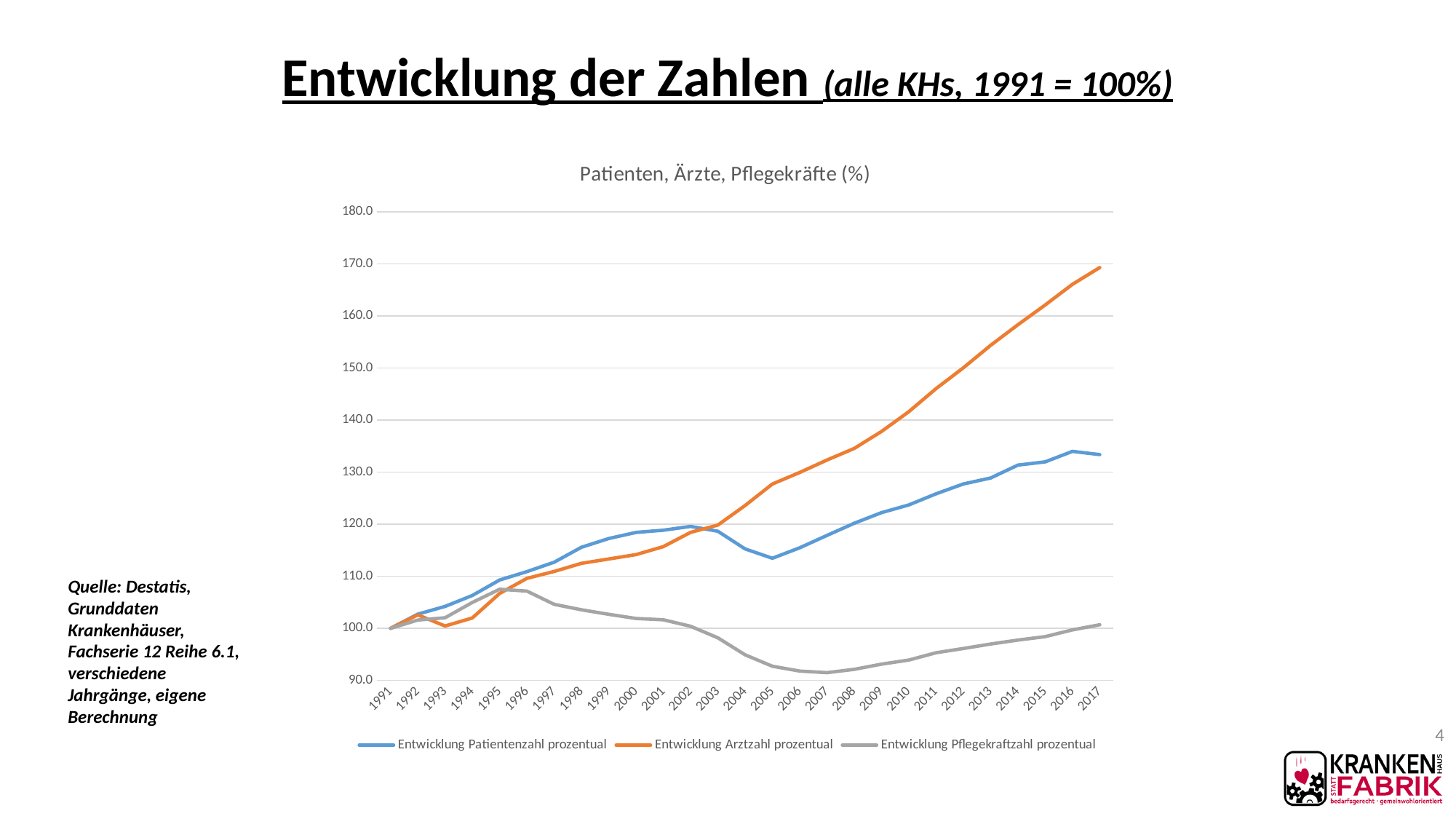
What is the value of 'Entwicklung Patientenzahl prozentual' in 1991? 100.0 Which colour is used for the series 'Entwicklung Arztzahl prozentual'? Orange How many years are plotted along the x axis? 27 Is the value for 'Entwicklung Arztzahl prozentual' in 2017 greater or less than 160.0? greater Does the series 'Entwicklung Arztzahl prozentual' generally rise or fall from 1991 to 2017? Rise In 2007, which is larger: 'Entwicklung Patientenzahl prozentual' or 'Entwicklung Pflegekraftzahl prozentual'? Entwicklung Patientenzahl prozentual Which series has the lowest value in 2017? Entwicklung Pflegekraftzahl prozentual How many series does the legend list? 3 Is the value for 'Entwicklung Pflegekraftzahl prozentual' in 2007 greater or less than 100.0? less What is the title of the chart? Patienten, Ärzte, Pflegekräfte (%) Which series has the highest value in 2017? Entwicklung Arztzahl prozentual What kind of chart is shown on the slide? Line chart